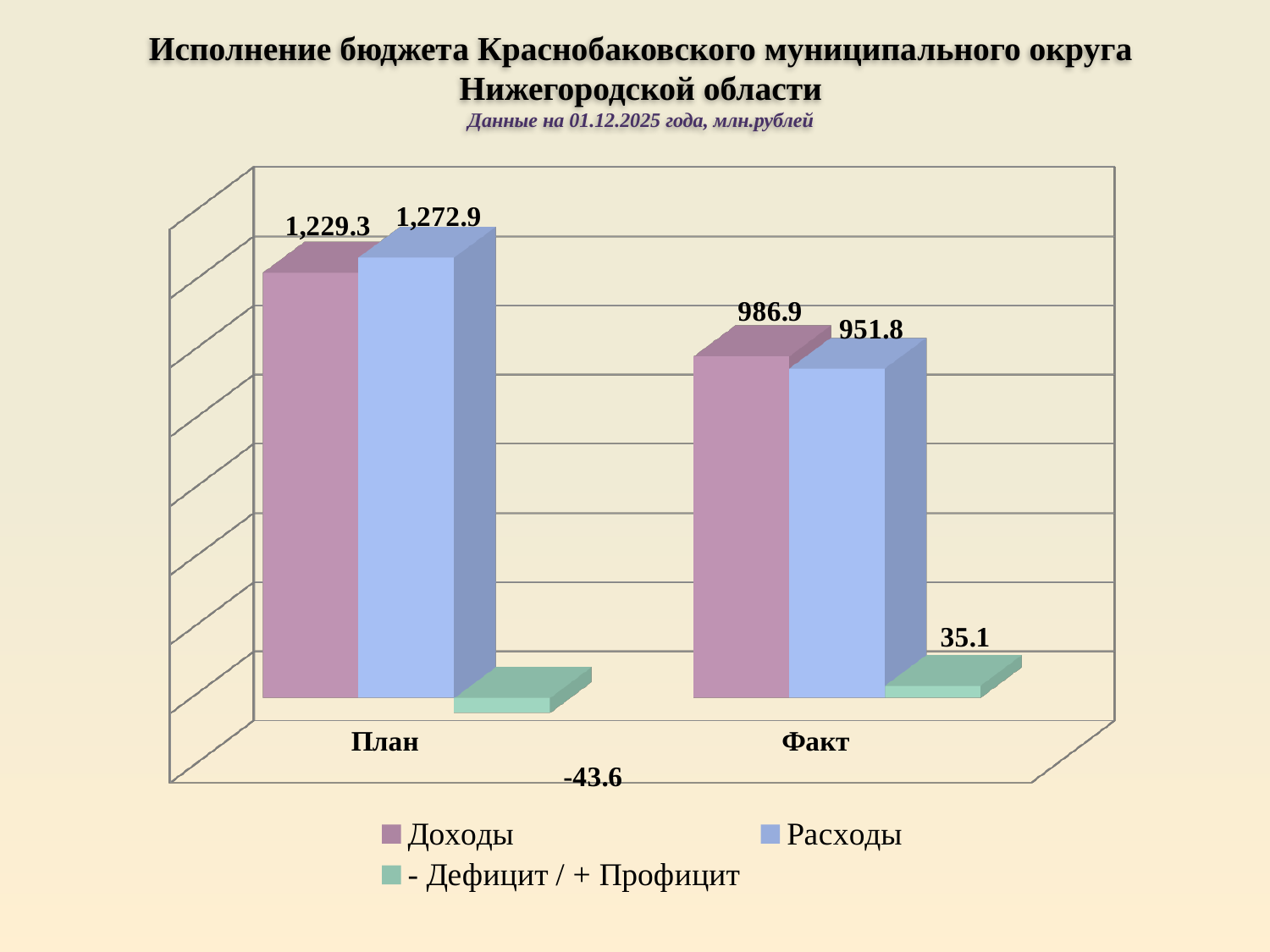
What kind of chart is shown on the slide? Bar chart Which category has the higher Расходы value, План or Факт? План How many series does the legend list? 3 How many categories are shown on the x axis? 2 What is the value of the - Дефицит / + Профицит series for Факт? 35.1 For Факт, which is larger, Доходы or Расходы? Доходы What is the value of the - Дефицит / + Профицит series for План? -43.6 Which series is shown in blue in the legend? Расходы What is the difference between Расходы and Доходы for План? 43.6 What is the value of Расходы for Факт? 951.8 What is the difference between Доходы for План and Доходы for Факт? 242.4 What is the value of Доходы for План? 1,229.3